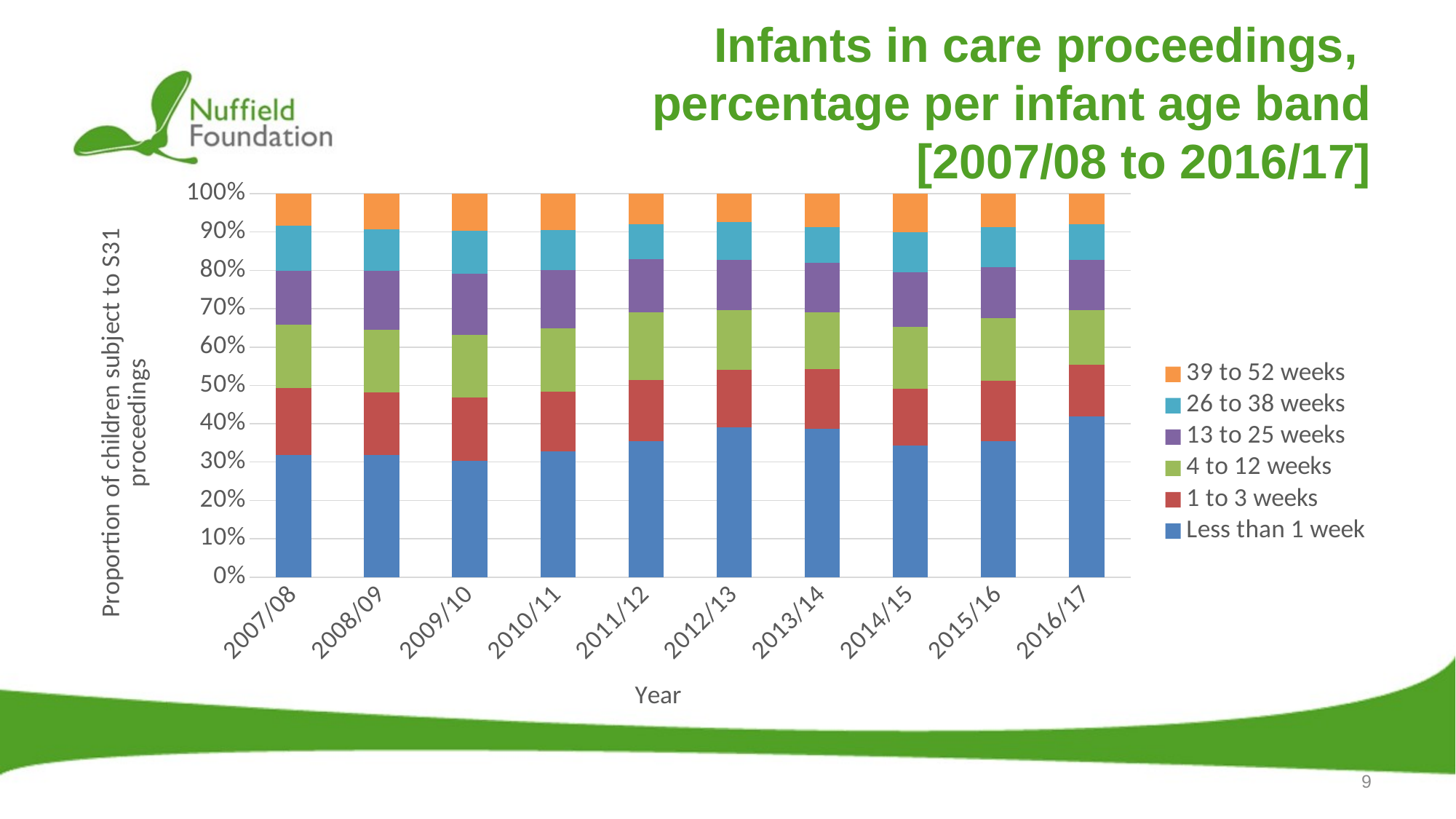
What does each stacked bar total? 100% Which year has the larger 'Less than 1 week' share, 2007/08 or 2016/17? 2016/17 Is the 'Less than 1 week' value for 2016/17 greater or less than 40%? greater Does the 'Less than 1 week' share generally rise or fall from 2007/08 to 2016/17? Rise What is the label on the y axis of the chart? Proportion of children subject to S31 proceedings What kind of chart is shown on the slide? Stacked bar chart In which year is the 'Less than 1 week' segment the largest? 2016/17 Is the 'Less than 1 week' value for 2007/08 greater or less than 40%? less What is the title of the chart? Infants in care proceedings, percentage per infant age band [2007/08 to 2016/17] How many series does the chart's legend list? 6 How many years are shown along the x axis of the chart? 10